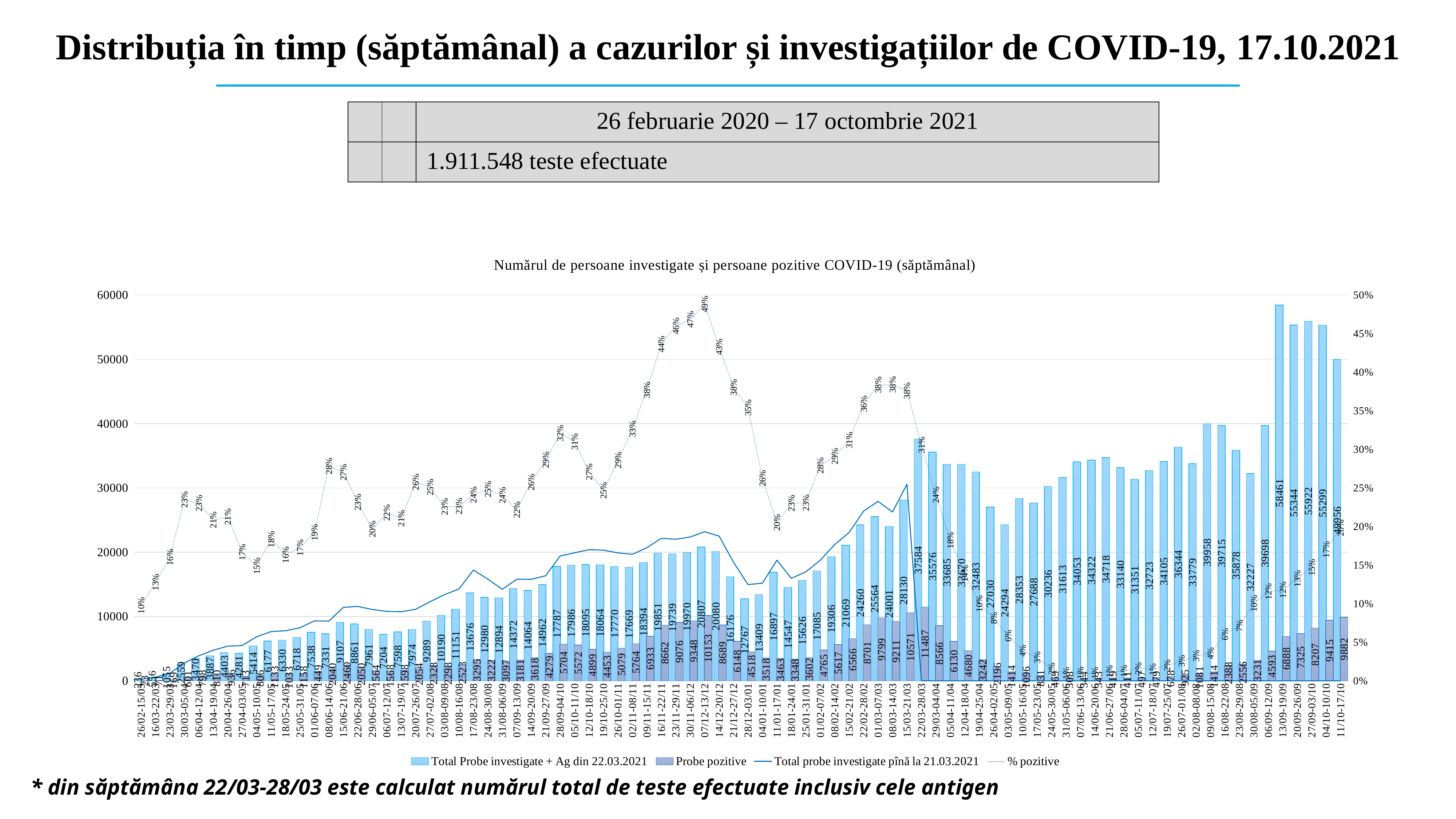
What is the value of Total Probe investigate for the week 13/09-19/09? 58461 How many series does the chart legend list? 4 What is the difference between Probe pozitive for 11/10-17/10 and for 04/10-10/10? 467 What is the chart's title? Numărul de persoane investigate și persoane pozitive COVID-19 (săptămânal) What is the value of Probe pozitive for the week 04/10-10/10? 9415 Is the Total Probe investigate value for the week 22/03-28/03 greater or less than 30000? greater What is the highest value of % pozitive shown on the chart? 49% Which week has the larger Total Probe investigate value: 04/10-10/10 or 06/09-12/09? 04/10-10/10 Which week has the highest Total Probe investigate bar? 13/09-19/09 What kind of chart is shown on the slide? A combined bar and line chart What is the value of Probe pozitive for the week 11/10-17/10? 9882 What is the difference between Total Probe investigate for 13/09-19/09 and for 20/09-26/09? 3117